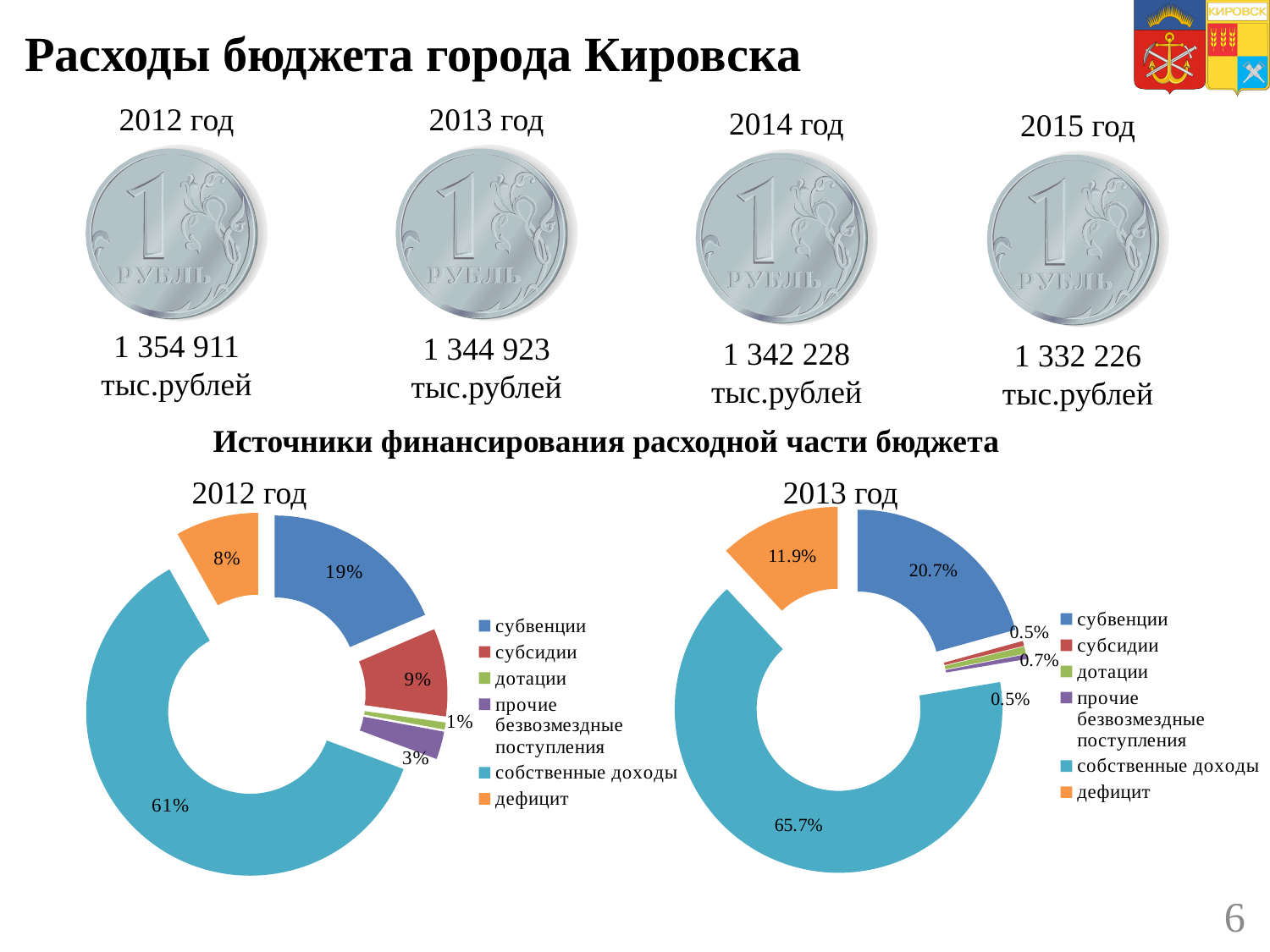
In the 2012 год chart, what is the difference between субвенции and субсидии? 10% In the 2013 год chart, what share is собственные доходы? 65.7% In the 2012 год chart, which category has the smallest share? дотации In the 2012 год chart, what share is дефицит? 8% What kind of chart is the 2012 год chart? doughnut chart How many categories does the legend of the 2013 год chart list? 6 In the 2013 год chart, what share is субвенции? 20.7% In the 2012 год chart, what share is субвенции? 19% In the 2013 год chart, what share is дефицит? 11.9% In the 2012 год chart, what share is собственные доходы? 61% In the 2013 год chart, which is larger, субвенции or дефицит? субвенции In the 2012 год chart, which category has the largest share? собственные доходы